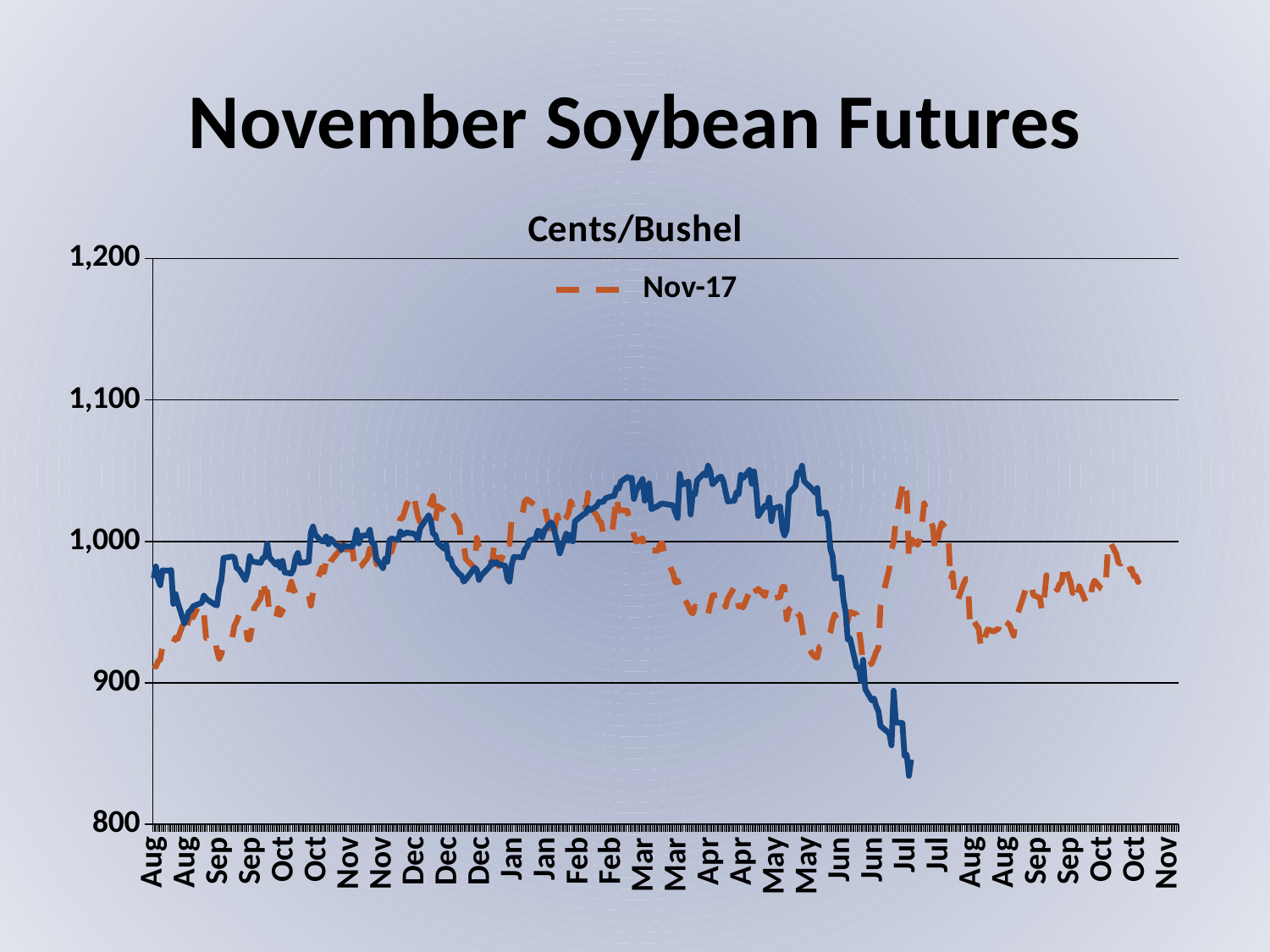
What kind of chart is shown on the slide? line chart Is the highest value of the Nov-17 line greater or less than 1,100? less Is the solid blue line's value in Mar greater or less than 1,000? greater Does the solid blue line rise or fall between May and Jul? fall How many series does the legend list? 1 Is the Nov-17 value in Apr greater or less than 1,000? less Does the Nov-17 line rise or fall between Aug and Dec? rise What is the title of the chart? Cents/Bushel What unit label is shown above the chart? Cents/Bushel